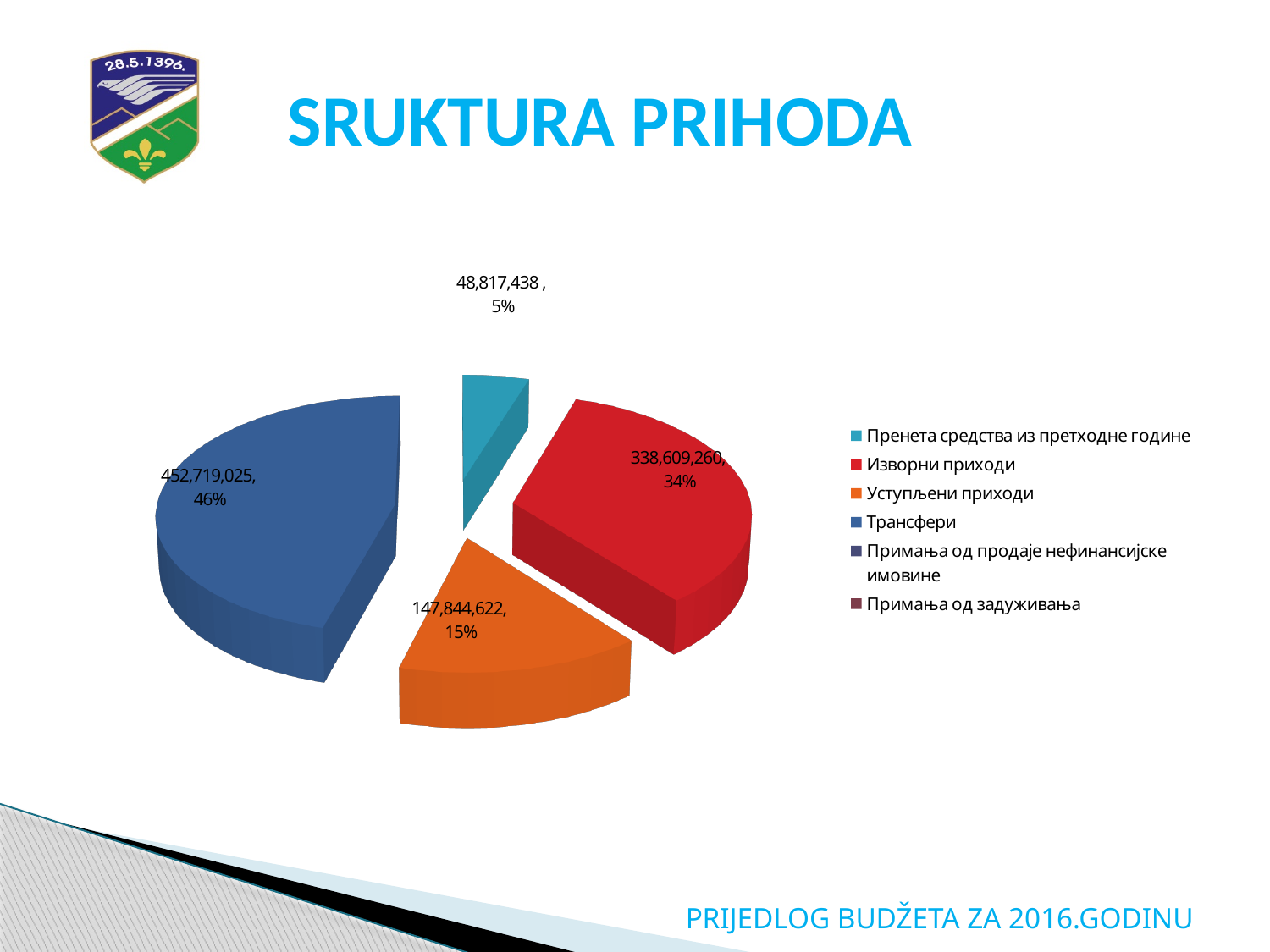
What is the value shown for Уступљени приходи? 147,844,622 Which category has the smallest visible slice of the pie? Пренета средства из претходне године What is the value shown for Пренета средства из претходне године? 48,817,438 Which category has the largest slice of the pie? Трансфери What is the value shown for Трансфери? 452,719,025 What type of chart is shown on the slide? pie chart What share of the pie does Изворни приходи represent? 34% How many entries does the legend list? 6 What share of the pie does Трансфери represent? 46% Which is larger, the value for Уступљени приходи or the value for Пренета средства из претходне године? Уступљени приходи What is the value shown for Изворни приходи? 338,609,260 What is the difference between the values for Трансфери and Изворни приходи? 114,109,765